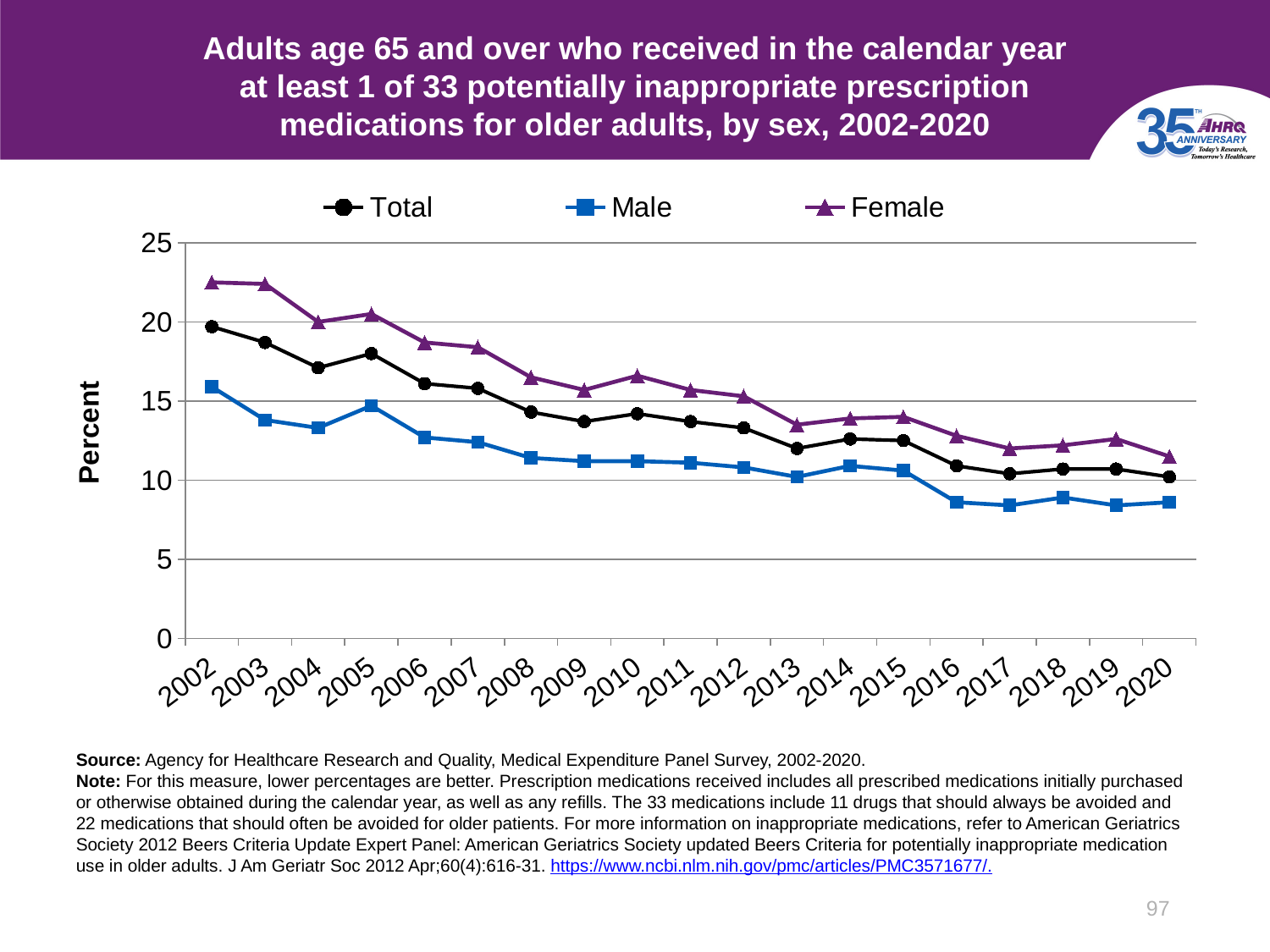
In 2010, which is larger, the Female value or the Male value? Female How many years are plotted along the x axis? 19 How many series does the legend list? 3 Which series has the lowest value in 2002? Male Which series has the highest value in 2015? Female Do the Female values rise or fall from 2002 to 2020? fall Do the Male values rise or fall from 2002 to 2020? fall Is the Total value for 2002 greater or less than 15? greater What kind of chart is shown on the slide? line chart Is the Male value for 2020 greater or less than 10? less Is the Female value for 2002 greater or less than 20? greater